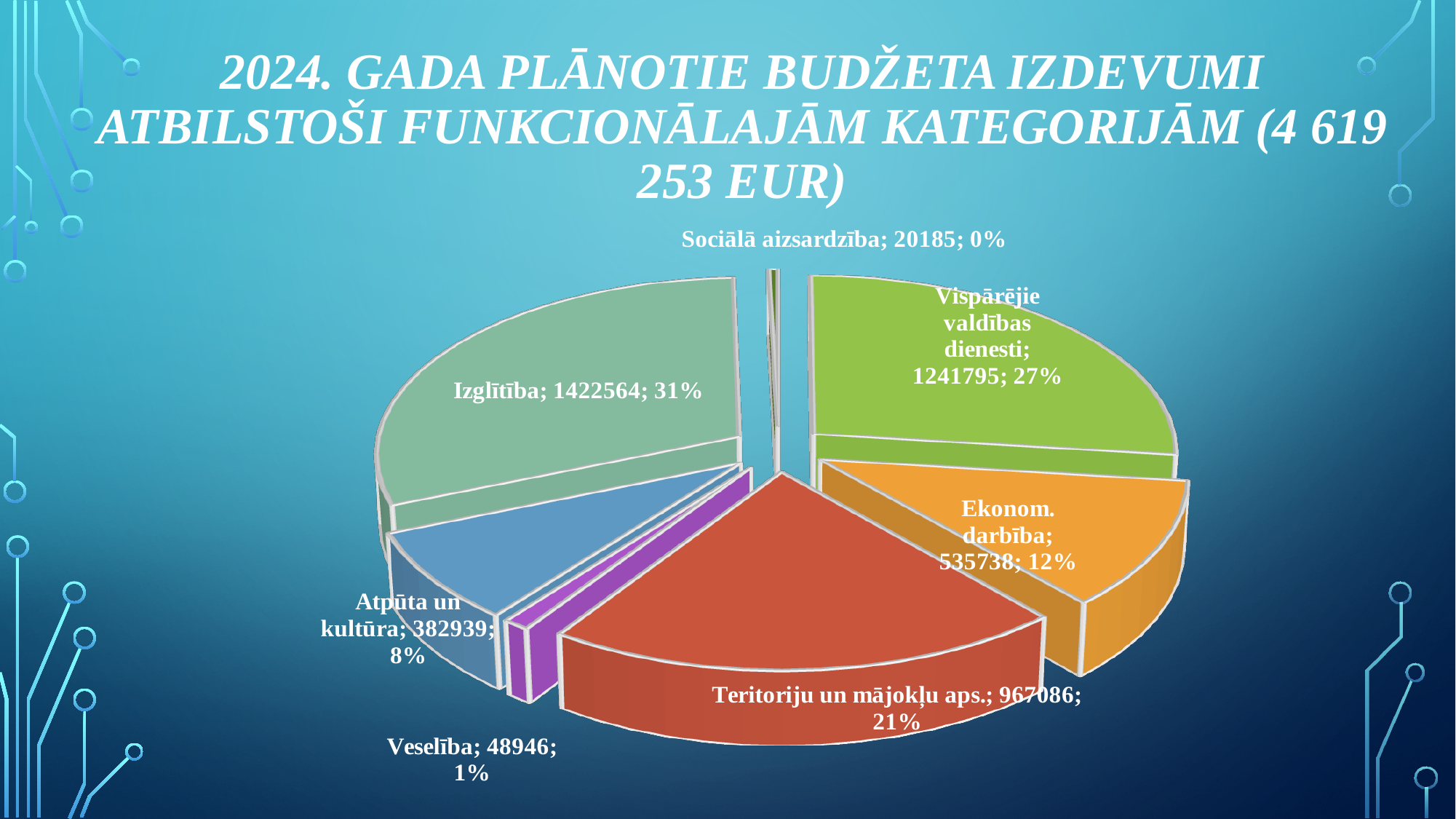
What is the value for Vispārējie valdības dienesti? 1241795 What is the difference between the values for Izglītība and Vispārējie valdības dienesti? 180769 What is the value for Izglītība? 1422564 Which is larger, the value for Teritoriju un mājokļu aps. or the value for Ekonom. darbība? Teritoriju un mājokļu aps. What is the value for Teritoriju un mājokļu aps.? 967086 Which category has the largest share of the pie? Izglītība What is the value for Veselība? 48946 Which category has the smallest share of the pie? Sociālā aizsardzība What kind of chart is shown on the slide? pie chart What share of the pie does Ekonom. darbība represent? 12% What share of the pie does Atpūta un kultūra represent? 8% How many categories (slices) does the pie chart show? 7